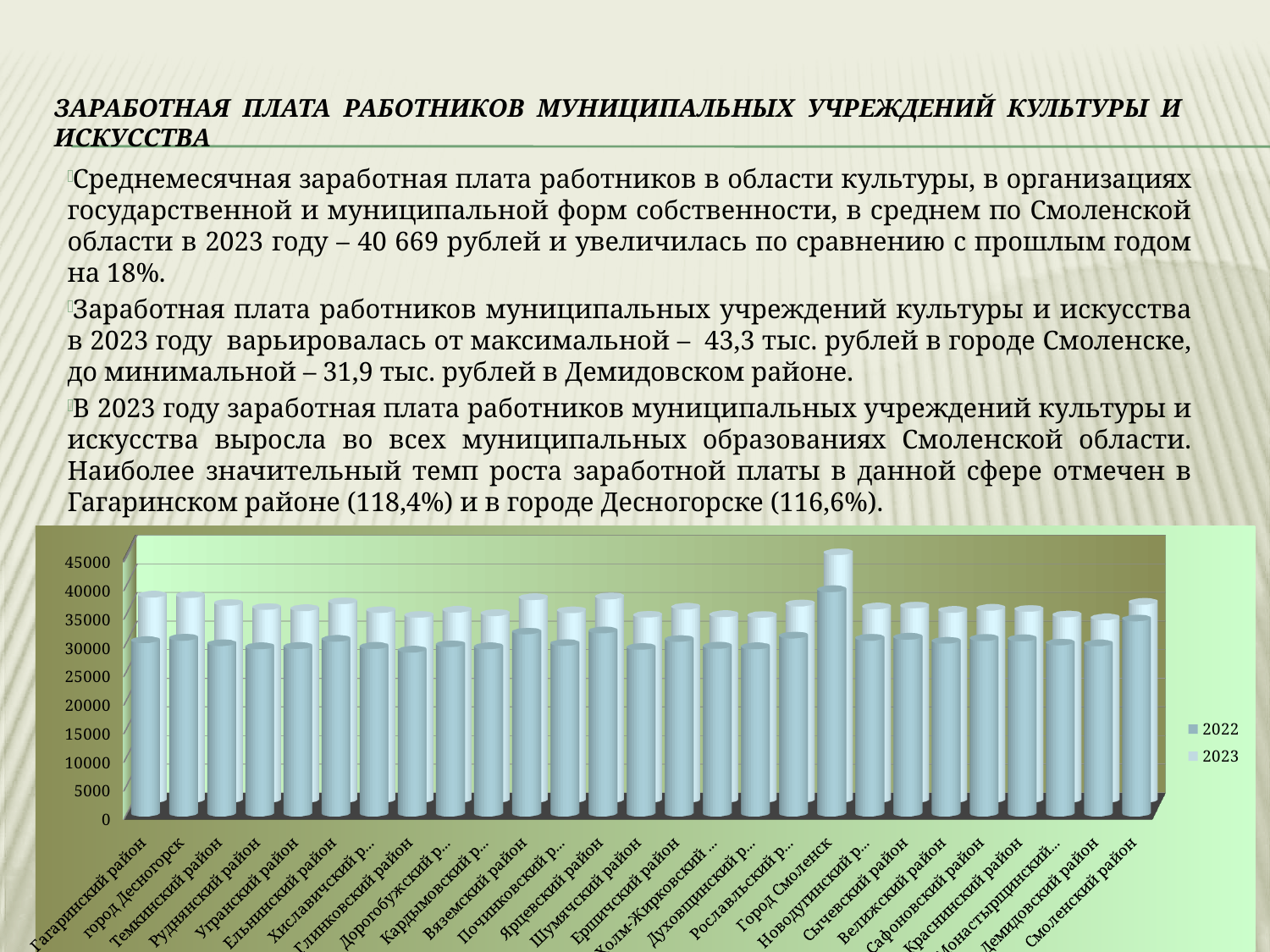
Is the 2022 value for Гагаринский район greater or less than 25000? greater Is the 2022 value for город Смоленск greater or less than 35000? greater Which municipality has the highest 2022 value in the chart? город Смоленск Is the 2023 value for Демидовский район greater or less than 35000? less What is the highest value labelled on the vertical axis of the chart? 45000 How many series does the chart legend list? 2 Which municipality has the highest 2023 value in the chart? город Смоленск What kind of chart is shown on the slide? bar chart Which years are listed in the chart legend? 2022 and 2023 For Гагаринский район, which series has the larger value, 2022 or 2023? 2023 How many municipalities (categories) are shown on the x axis of the chart? 27